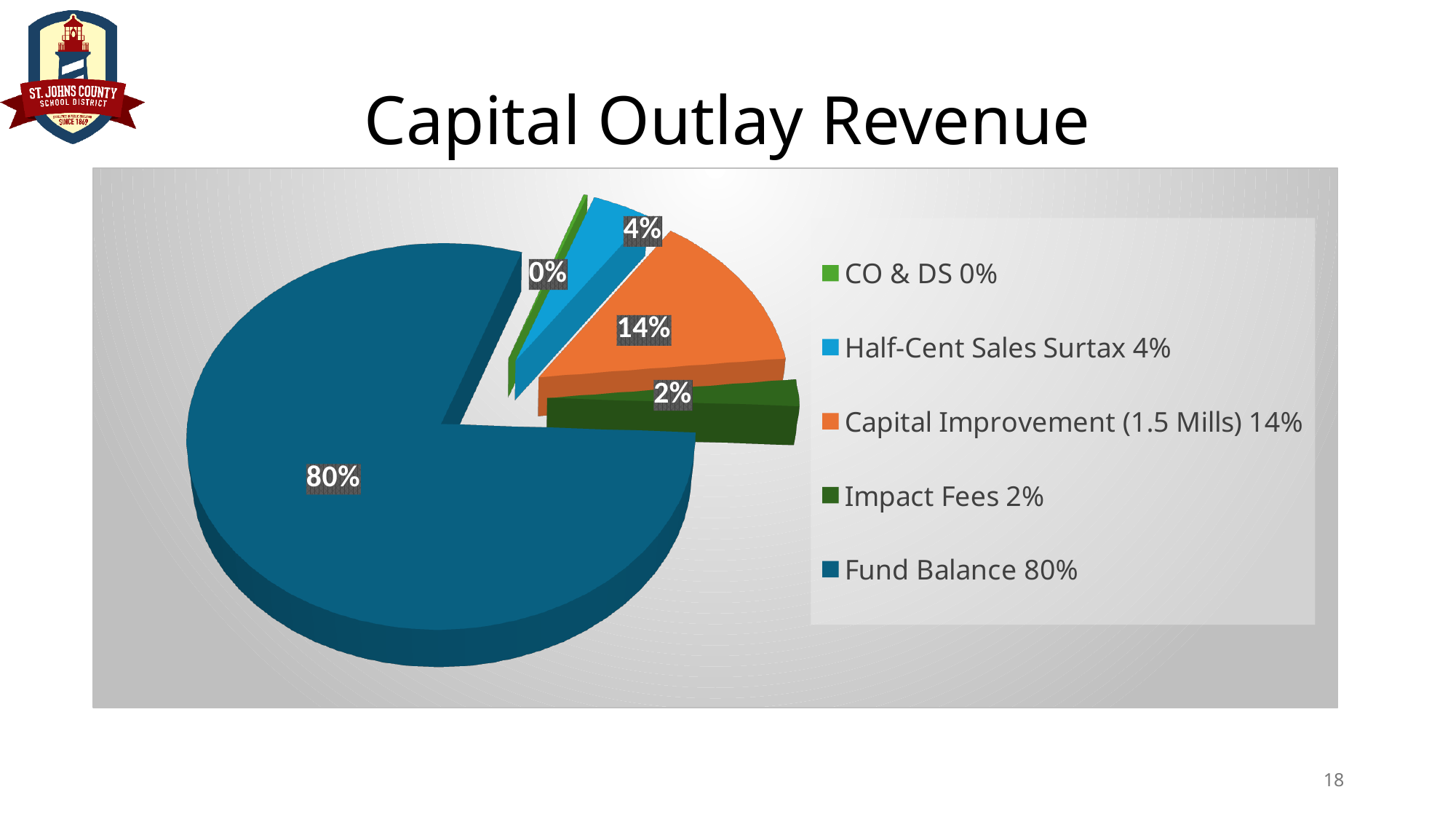
What is the title of the chart? Capital Outlay Revenue What share of Capital Outlay Revenue comes from Fund Balance? 80% What share of Capital Outlay Revenue comes from CO & DS? 0% What share of Capital Outlay Revenue comes from Half-Cent Sales Surtax? 4% Which category has the largest share of Capital Outlay Revenue? Fund Balance What is the difference in percentage points between Fund Balance and Capital Improvement (1.5 Mills)? 66 Which category has the smallest share of Capital Outlay Revenue? CO & DS Which is larger, the share for Half-Cent Sales Surtax or the share for Impact Fees? Half-Cent Sales Surtax How many categories does the pie chart show? 5 What kind of chart is shown on the slide? Pie chart